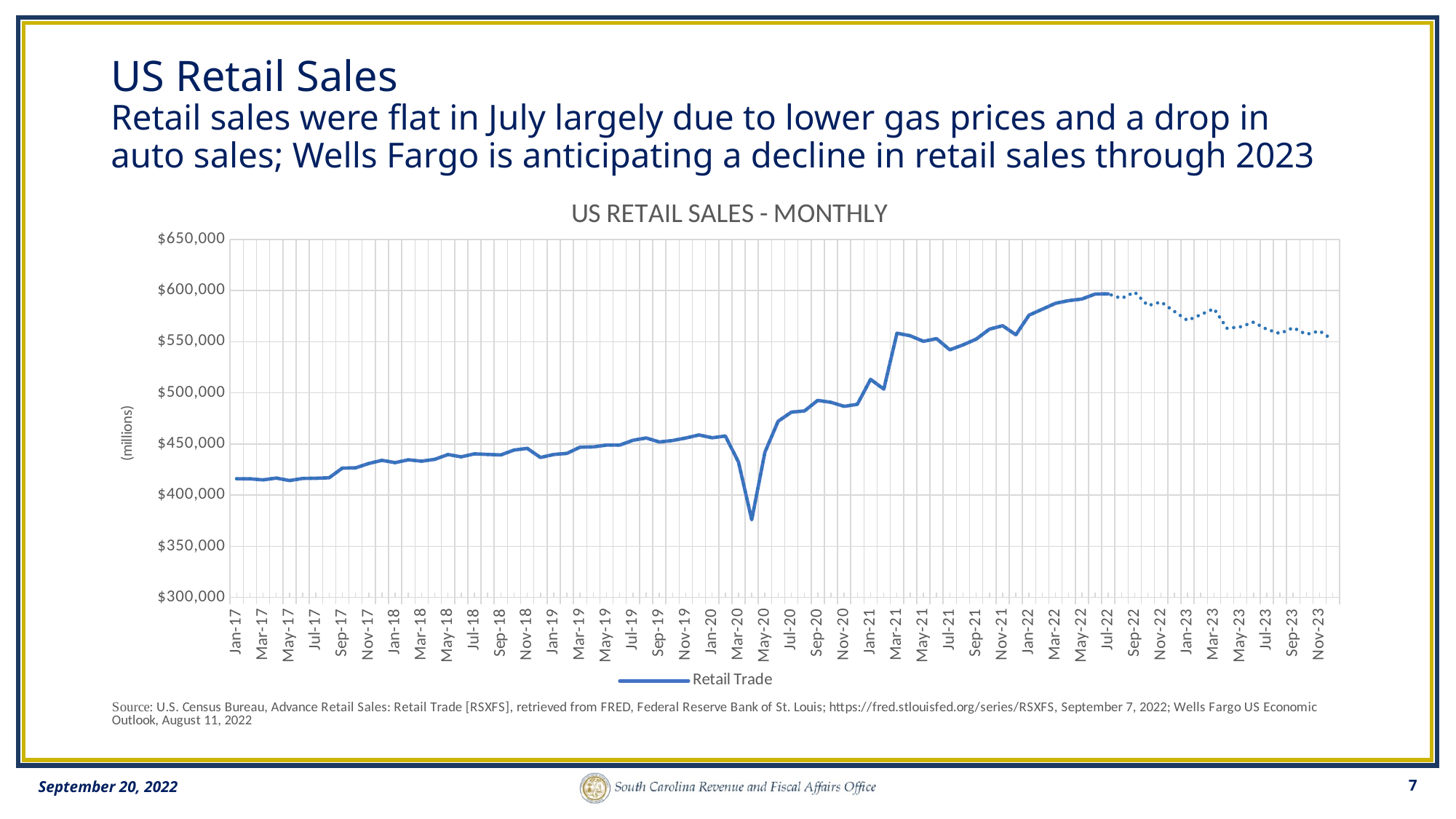
What kind of chart is shown on the slide? Line chart Is the lowest point of the line, in 2020, greater or less than $400,000? less What is the title of the chart? US RETAIL SALES - MONTHLY In which year does the line reach its lowest point? 2020 Is the value for Jan-17 greater or less than $450,000? less Is the value for Mar-21 greater or less than $500,000? greater Does the line generally rise or fall from Jan-17 to Jan-20? Rise What series name appears in the chart legend? Retail Trade How many series does the legend list? 1 Which is larger, the value for Jan-17 or the value for Jul-22? Jul-22